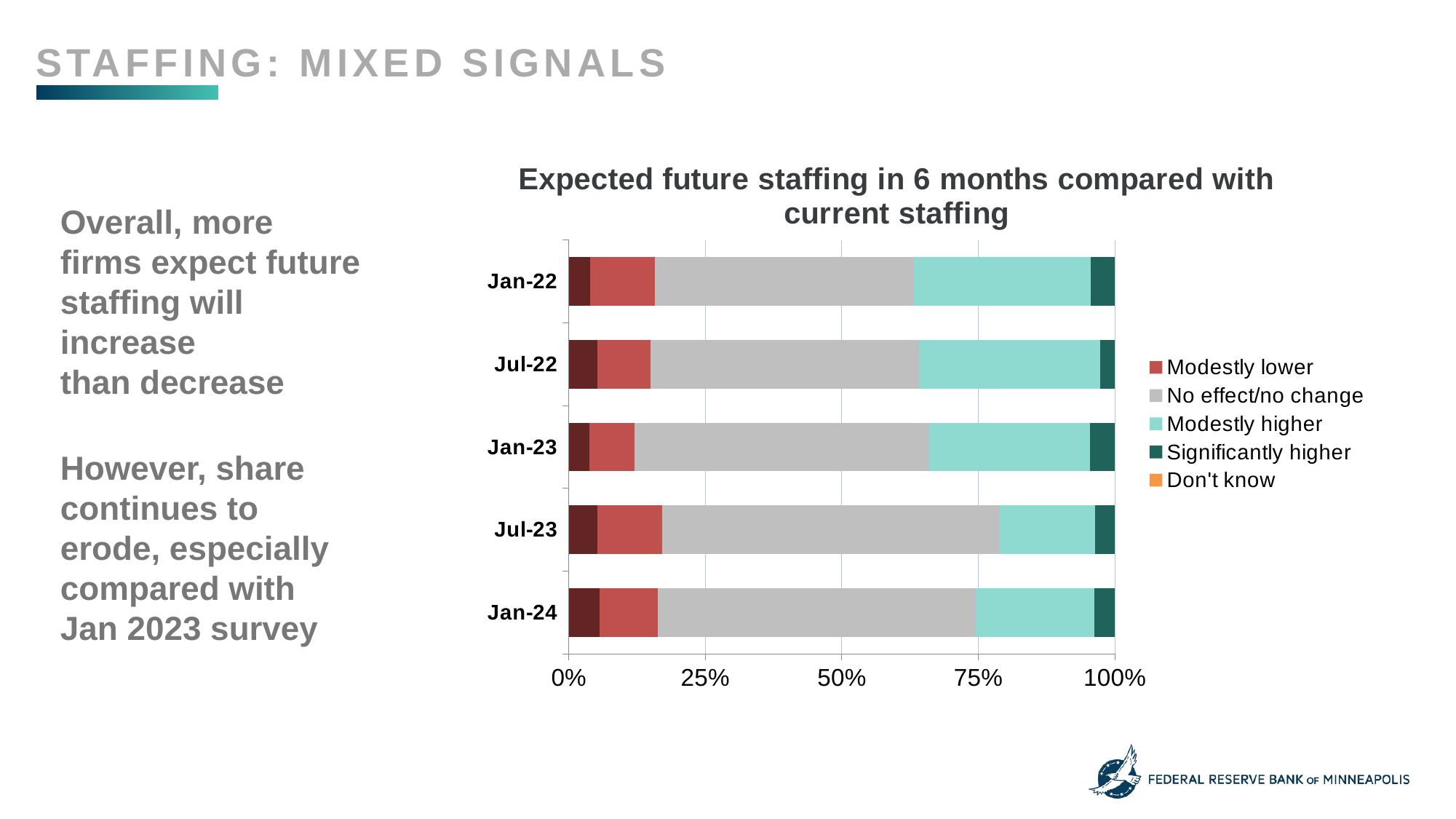
How many series does the chart legend list? 5 What is the title of the chart? Expected future staffing in 6 months compared with current staffing Which legend entry is shown in orange? Don't know Is the Modestly higher segment larger for Jan-22 or for Jan-24? Jan-22 In the Jul-23 bar, does the No effect/no change segment end at a point greater or less than 75%? greater Does the No effect/no change share rise or fall from Jan-22 through Jul-23? rise Is the No effect/no change segment larger for Jul-23 or for Jan-22? Jul-23 Is the Modestly higher segment larger for Jan-23 or for Jul-23? Jan-23 How many survey periods (bars) are shown in the chart? 5 In the Jan-22 bar, does the No effect/no change segment end at a point greater or less than 75%? less What kind of chart is shown on the slide? Stacked bar chart Which survey period is the bottom bar of the chart? Jan-24